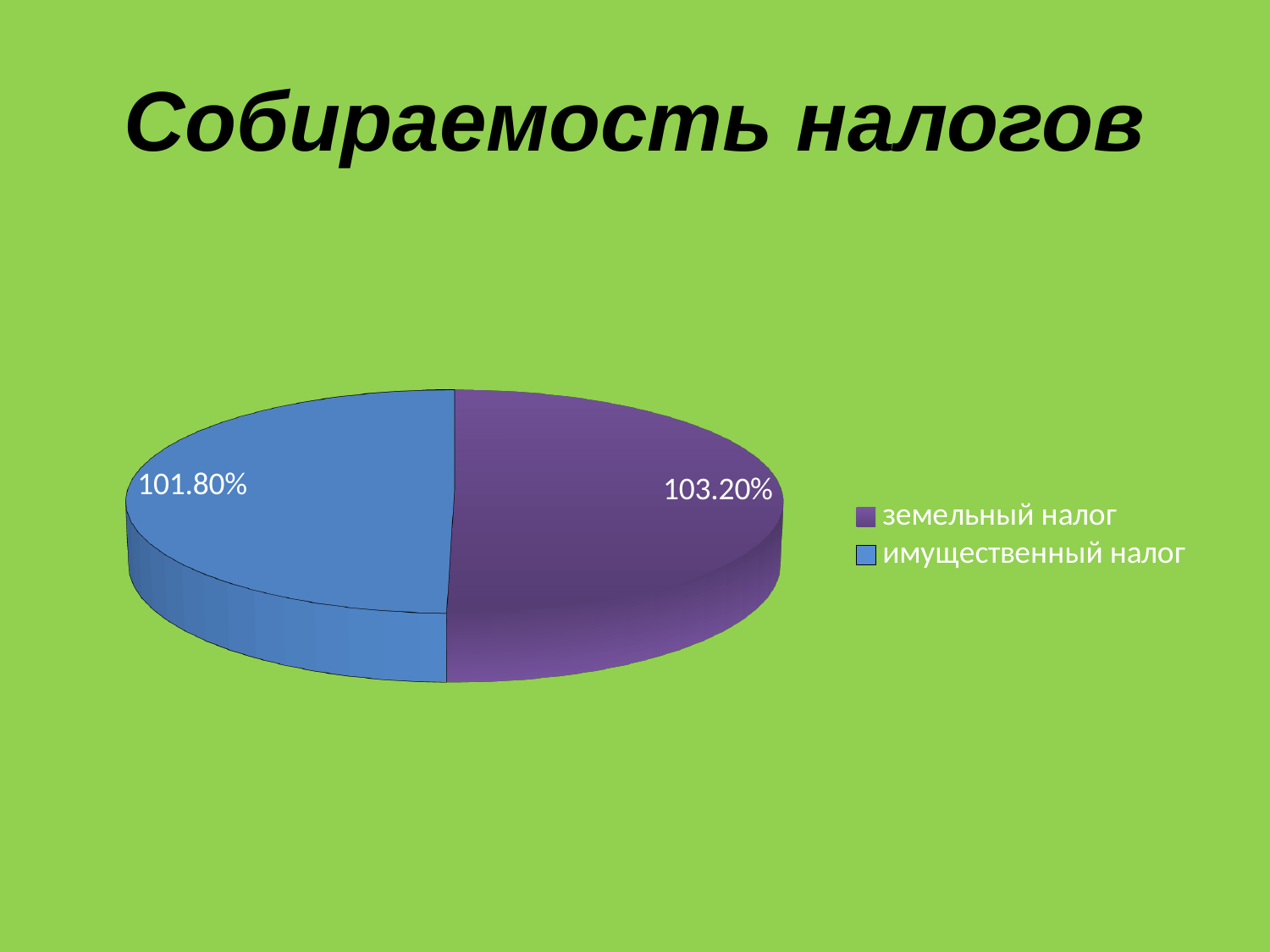
How many slices does the pie chart have? 2 Which category has the lowest value? имущественный налог Which is larger, the value for земельный налог or the value for имущественный налог? земельный налог What colour is the slice for имущественный налог? Blue What kind of chart is shown on the slide? Pie chart What value is shown for имущественный налог? 101.80% How many entries does the legend list? 2 What value is shown for земельный налог? 103.20% What is the difference between the value for земельный налог and the value for имущественный налог? 1.40% Which category has the highest value? земельный налог What is the title of the slide? Собираемость налогов